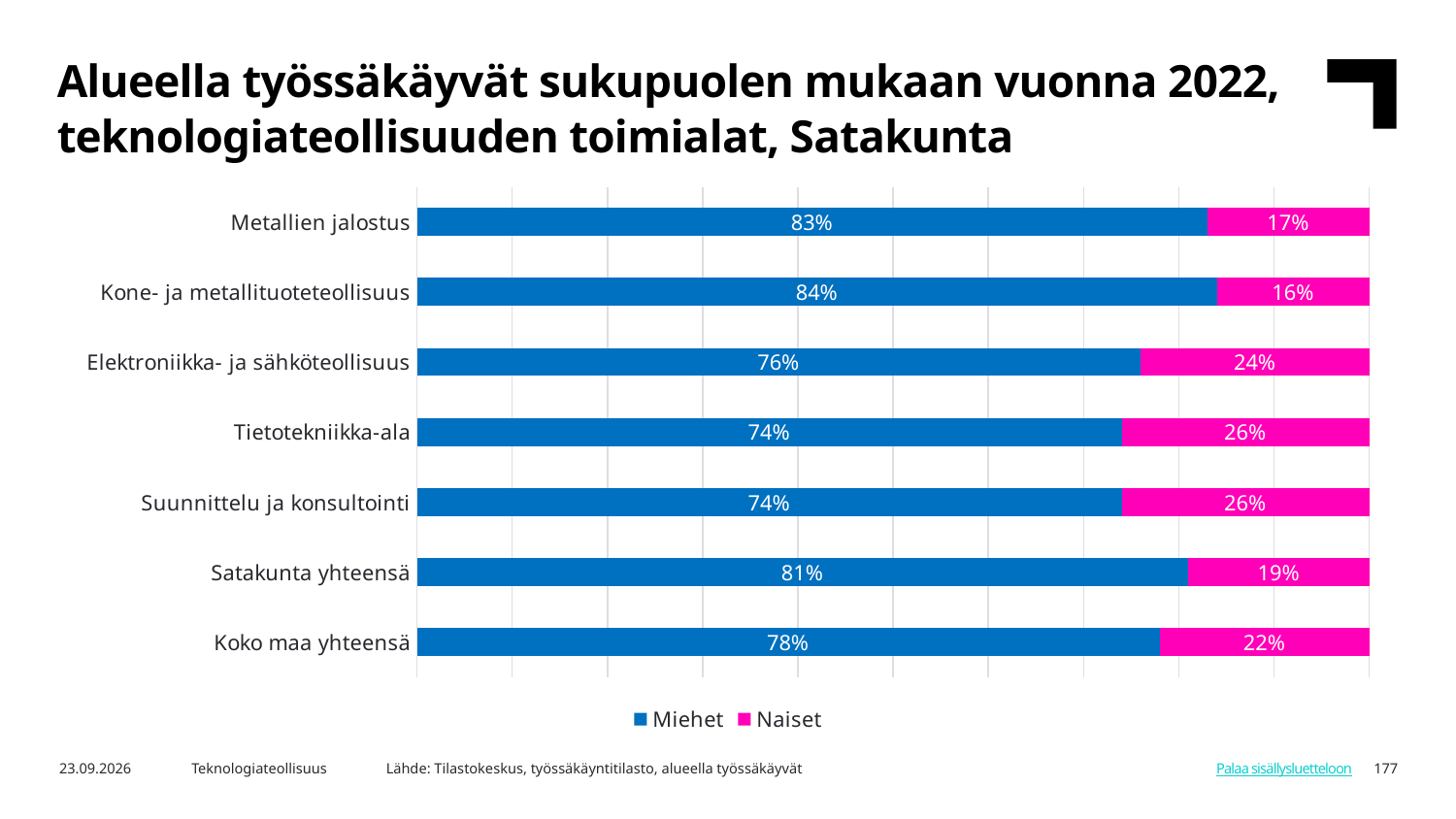
What is the difference between the Miehet share for Kone- ja metallituoteteollisuus and for Tietotekniikka-ala? 10 percentage points What is the Miehet share for Metallien jalostus? 83% How many series does the legend list? 2 How many categories are shown on the chart? 7 Which category has the lowest Naiset share? Kone- ja metallituoteteollisuus What is the Miehet share for Satakunta yhteensä? 81% What is the Naiset share for Koko maa yhteensä? 22% What is the total of the stacked bar for Suunnittelu ja konsultointi? 100% Which is larger: the Naiset share for Satakunta yhteensä or for Koko maa yhteensä? Koko maa yhteensä What kind of chart is shown on the slide? Stacked bar chart What is the Naiset share for Elektroniikka- ja sähköteollisuus? 24% Which category has the highest Miehet share? Kone- ja metallituoteteollisuus